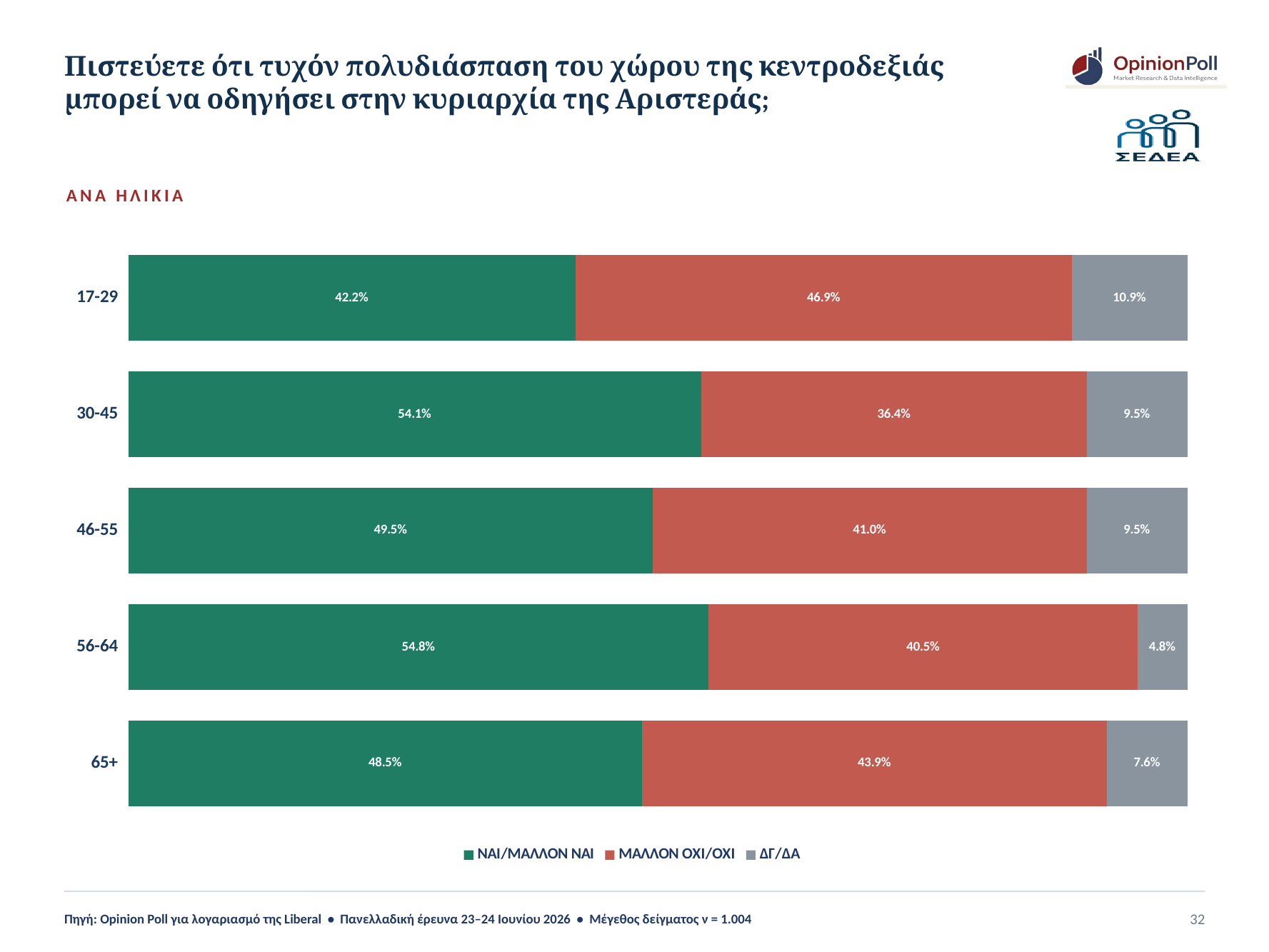
What kind of chart is shown on the slide? Stacked bar chart What percentage of the 30-45 age group answered ΝΑΙ/ΜΑΛΛΟΝ ΝΑΙ? 54.1% Which age group has the lowest ΔΓ/ΔΑ share? 56-64 How many age groups are shown in the chart? 5 Which age group has the highest ΜΑΛΛΟΝ ΟΧΙ/ΟΧΙ share? 17-29 In the 65+ age group, which is larger: ΝΑΙ/ΜΑΛΛΟΝ ΝΑΙ or ΜΑΛΛΟΝ ΟΧΙ/ΟΧΙ? ΝΑΙ/ΜΑΛΛΟΝ ΝΑΙ Which age group has the lowest ΝΑΙ/ΜΑΛΛΟΝ ΝΑΙ share? 17-29 What is the ΔΓ/ΔΑ value for the 17-29 age group? 10.9% What is the ΜΑΛΛΟΝ ΟΧΙ/ΟΧΙ value for the 65+ age group? 43.9% Which colour represents ΔΓ/ΔΑ in the chart? Grey How many series does the legend list? 3 What is the difference between the ΝΑΙ/ΜΑΛΛΟΝ ΝΑΙ and ΜΑΛΛΟΝ ΟΧΙ/ΟΧΙ values for the 30-45 age group? 17.7 percentage points